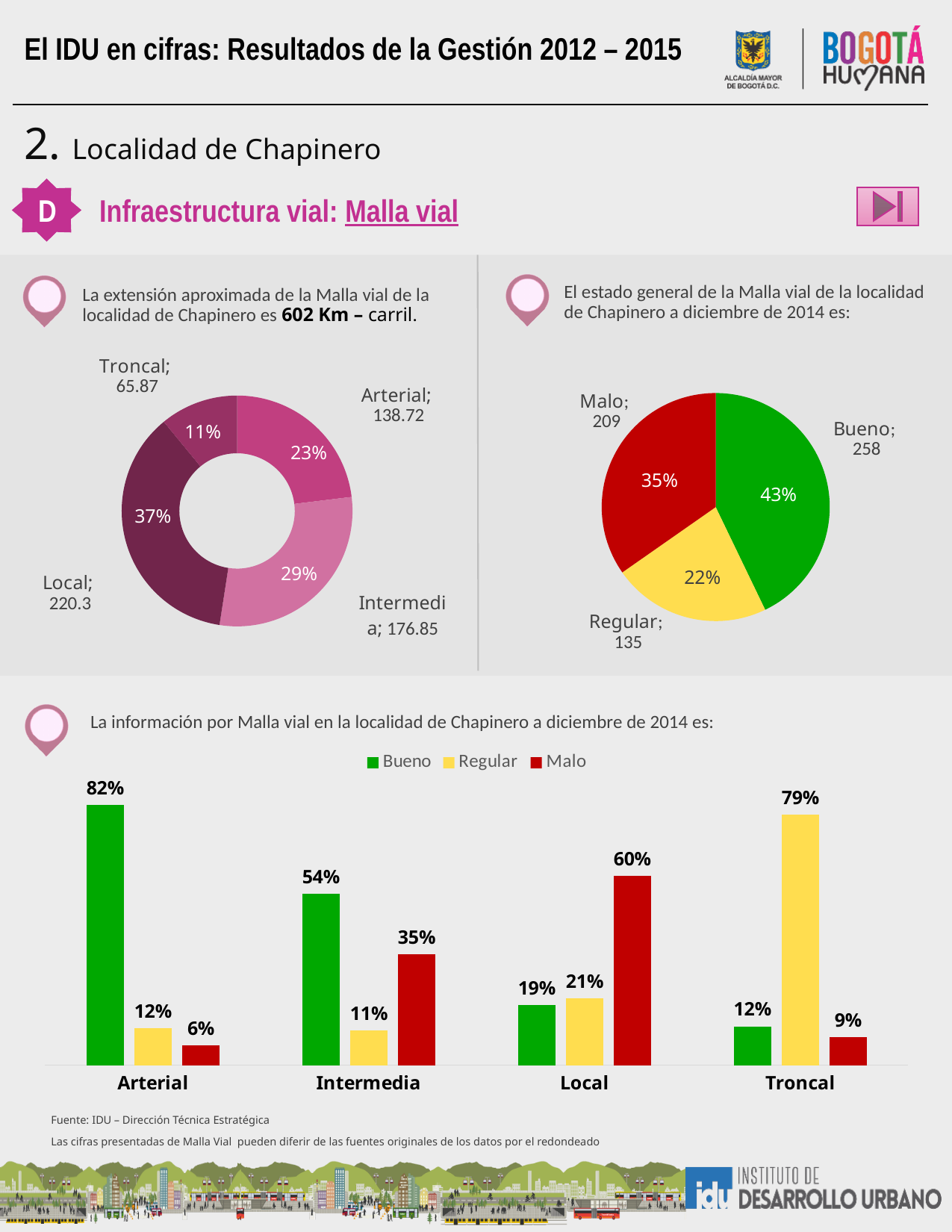
In the donut chart on the left, what percentage share does Troncal have? 11% In the bar chart at the bottom, how many series does the legend list? 3 In the pie chart on the right, what is the difference between the Bueno and Malo values? 49 In the pie chart on the right, what percentage share does Malo have? 35% In the bar chart at the bottom, which is larger for Local: Bueno or Malo? Malo In the pie chart on the right, what is the value for Bueno? 258 In the donut chart on the left, what is the value for Local? 220.3 In the bar chart at the bottom, what is the Bueno value for Arterial? 82% In the donut chart on the left, which category has the largest share? Local In the bar chart at the bottom, what is the Regular value for Troncal? 79% What kind of chart is the chart at the bottom of the slide? Bar chart In the pie chart on the right, which category is the smallest? Regular